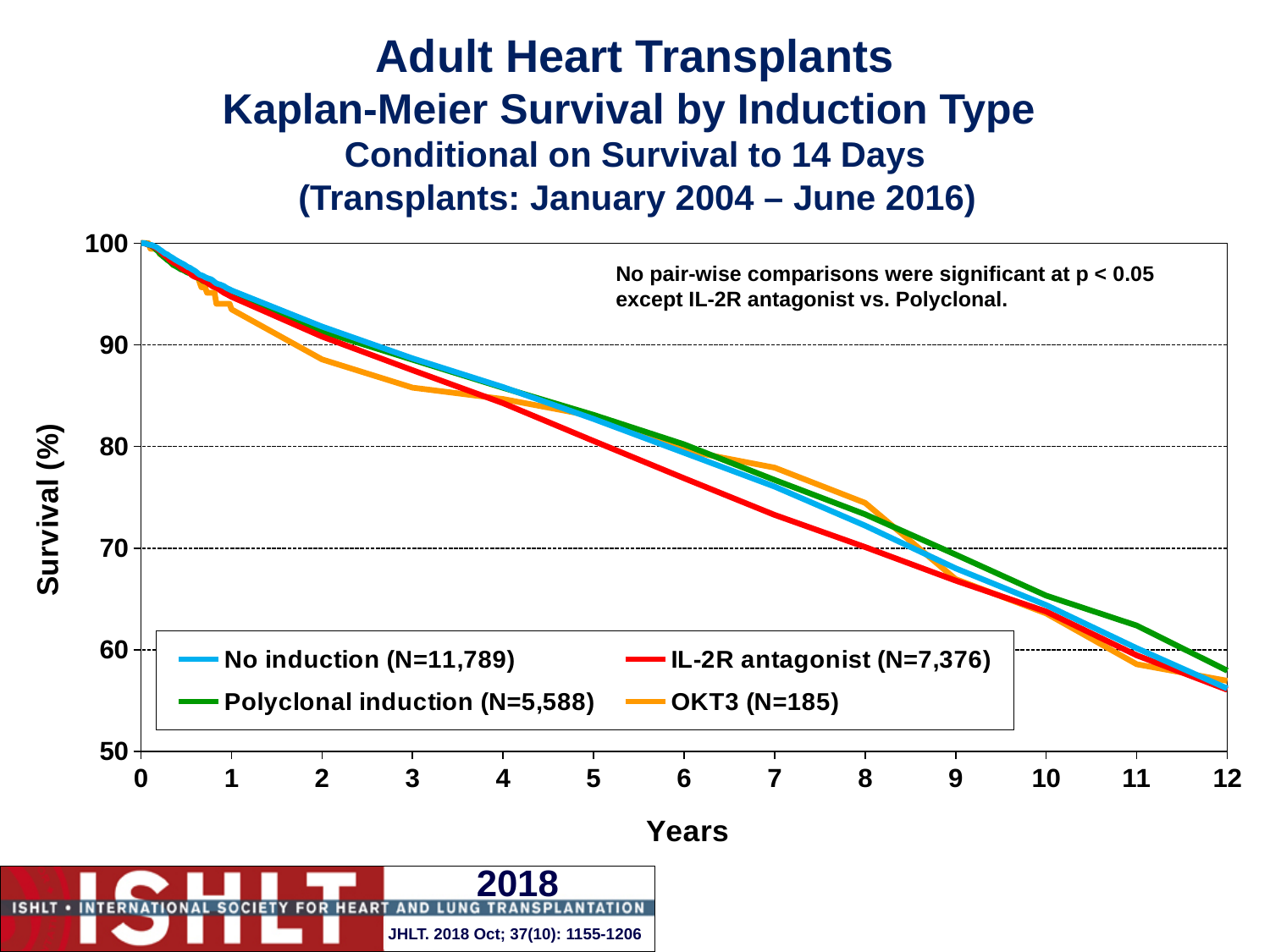
Is the survival value for Polyclonal induction at year 12 greater or less than 60? less Do the survival curves rise or fall as years increase? fall Is the survival value for IL-2R antagonist at year 6 greater or less than 80? less What kind of chart is shown on the slide? line chart At year 6, which series has higher survival: No induction or IL-2R antagonist? No induction Is the survival value for No induction at year 10 greater or less than 60? greater According to the legend, what is the N for the No induction group? N=11,789 How many series does the legend list? 4 At year 3, which series has higher survival: OKT3 or No induction? No induction According to the note on the chart, which pair-wise comparison was significant at p < 0.05? IL-2R antagonist vs. Polyclonal